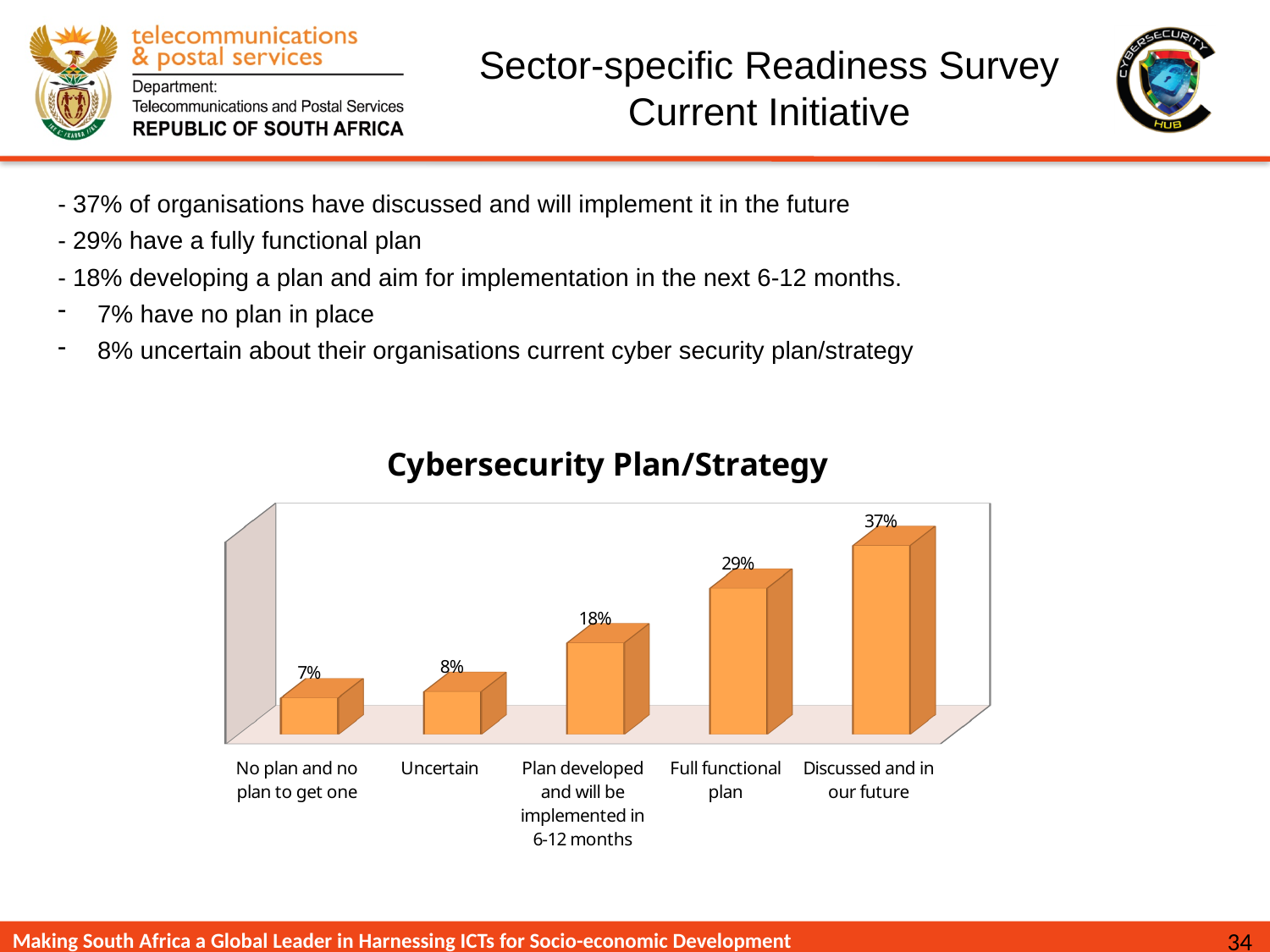
What is the title of the chart on the slide? Cybersecurity Plan/Strategy Which is larger: the value for "Full functional plan" or the value for "Plan developed and will be implemented in 6-12 months"? Full functional plan Which category has the highest value in the Cybersecurity Plan/Strategy chart? Discussed and in our future What is the value for "Uncertain" in the Cybersecurity Plan/Strategy chart? 8% Do the values rise or fall from left to right across the categories in the chart? Rise What is the value for "Full functional plan" in the Cybersecurity Plan/Strategy chart? 29% How many categories are shown in the Cybersecurity Plan/Strategy chart? 5 What kind of chart is shown on the slide? Bar chart What is the value for "Plan developed and will be implemented in 6-12 months"? 18% What is the difference between the values for "Plan developed and will be implemented in 6-12 months" and "Uncertain"? 10% Which category has the lowest value in the Cybersecurity Plan/Strategy chart? No plan and no plan to get one What is the difference between the values for "Discussed and in our future" and "Full functional plan"? 8%